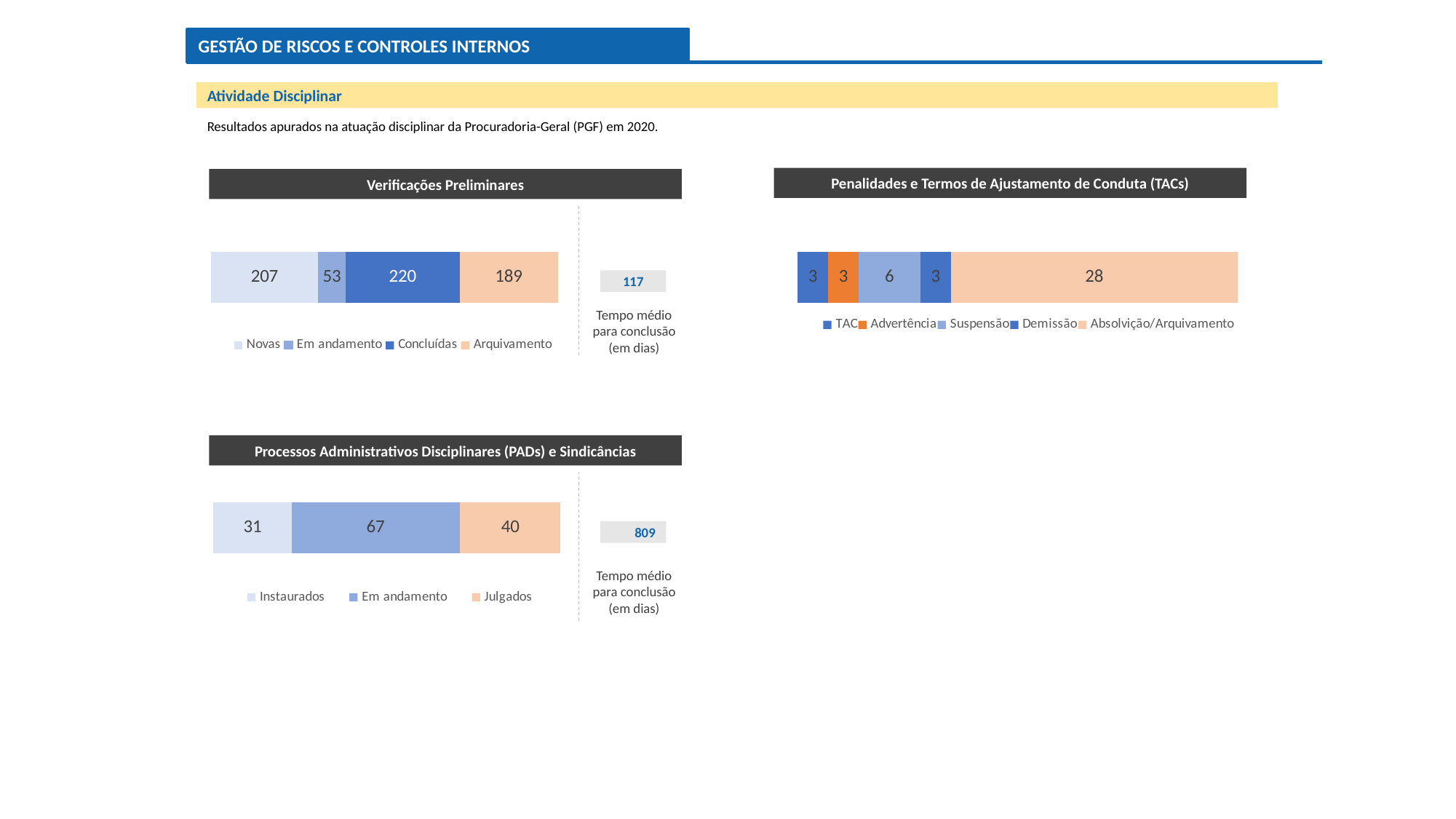
In the 'Penalidades e Termos de Ajustamento de Conduta (TACs)' chart, which segment has the highest value? Absolvição/Arquivamento What kind of chart is the 'Processos Administrativos Disciplinares (PADs) e Sindicâncias' chart? Stacked bar chart In the 'Verificações Preliminares' chart, which segment has the lowest value? Em andamento What is the average time to conclusion (in days) shown next to the 'Processos Administrativos Disciplinares (PADs) e Sindicâncias' chart? 809 In the 'Verificações Preliminares' chart, what is the difference between Novas and Arquivamento? 18 In the 'Penalidades e Termos de Ajustamento de Conduta (TACs)' chart, what is the value for Suspensão? 6 In the 'Verificações Preliminares' chart, what is the value for Concluídas? 220 How many series does the legend of the 'Penalidades e Termos de Ajustamento de Conduta (TACs)' chart list? 5 In the 'Processos Administrativos Disciplinares (PADs) e Sindicâncias' chart, what is the value for Em andamento? 67 In the 'Verificações Preliminares' chart, what is the total of the stacked bar? 669 In the 'Penalidades e Termos de Ajustamento de Conduta (TACs)' chart, what is the total of the stacked bar? 43 In the 'Processos Administrativos Disciplinares (PADs) e Sindicâncias' chart, which is larger, Instaurados or Julgados? Julgados